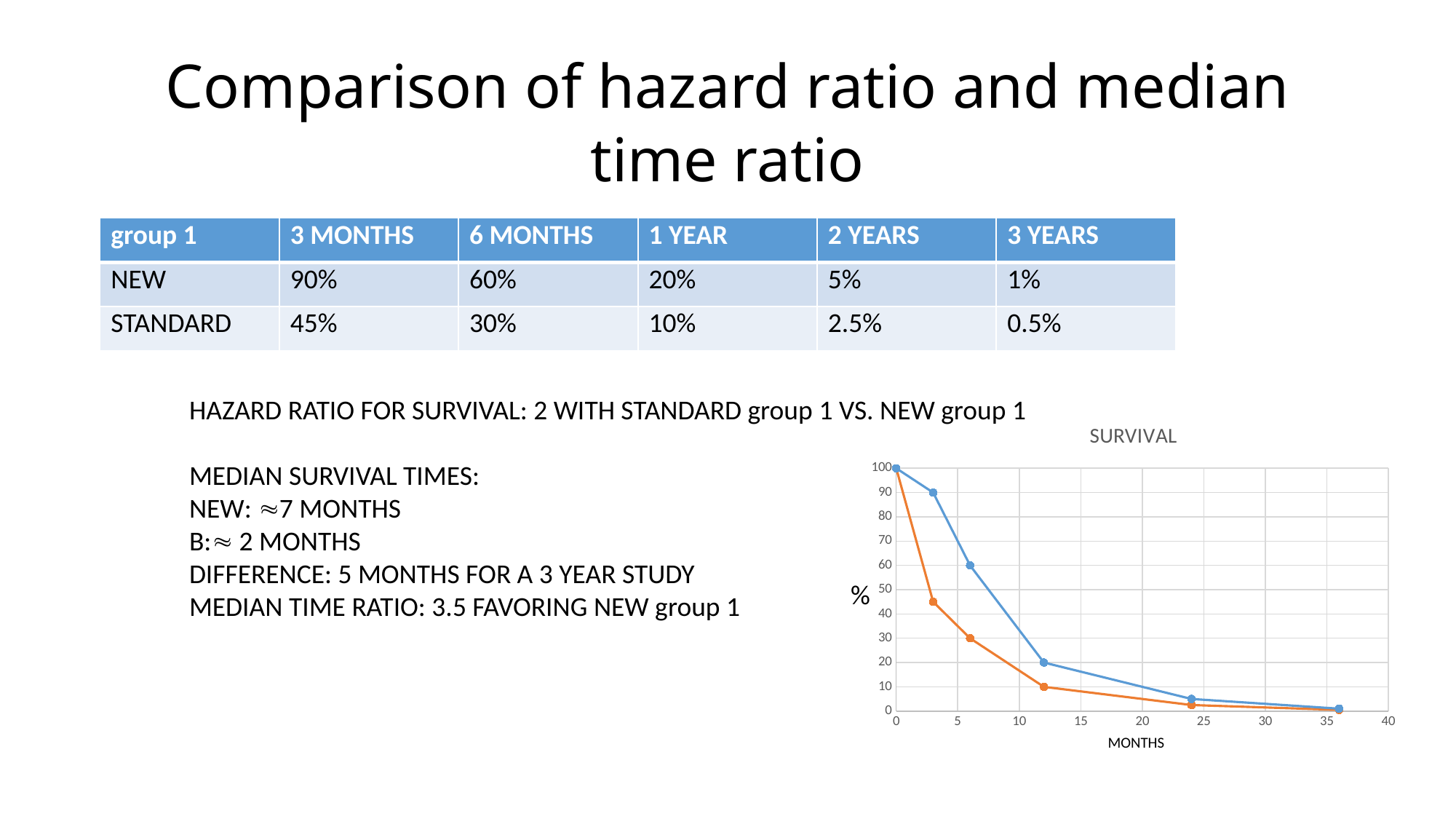
How many data points does the blue line have? 6 What is the value of the blue line at 6 months? 60 What is the label of the x axis of the chart? MONTHS What is the value of the blue line at 12 months? 20 What is the title of the chart? SURVIVAL Do the values of the blue line rise or fall as months increase? fall Is the value of the orange line at 3 months greater or less than 50? less How many lines are plotted on the chart? 2 What is the difference between the blue line and the orange line at 6 months? 30 At 3 months, which line has the higher value, blue or orange? blue What kind of chart is shown on the slide? line chart What is the value of the orange line at 6 months? 30